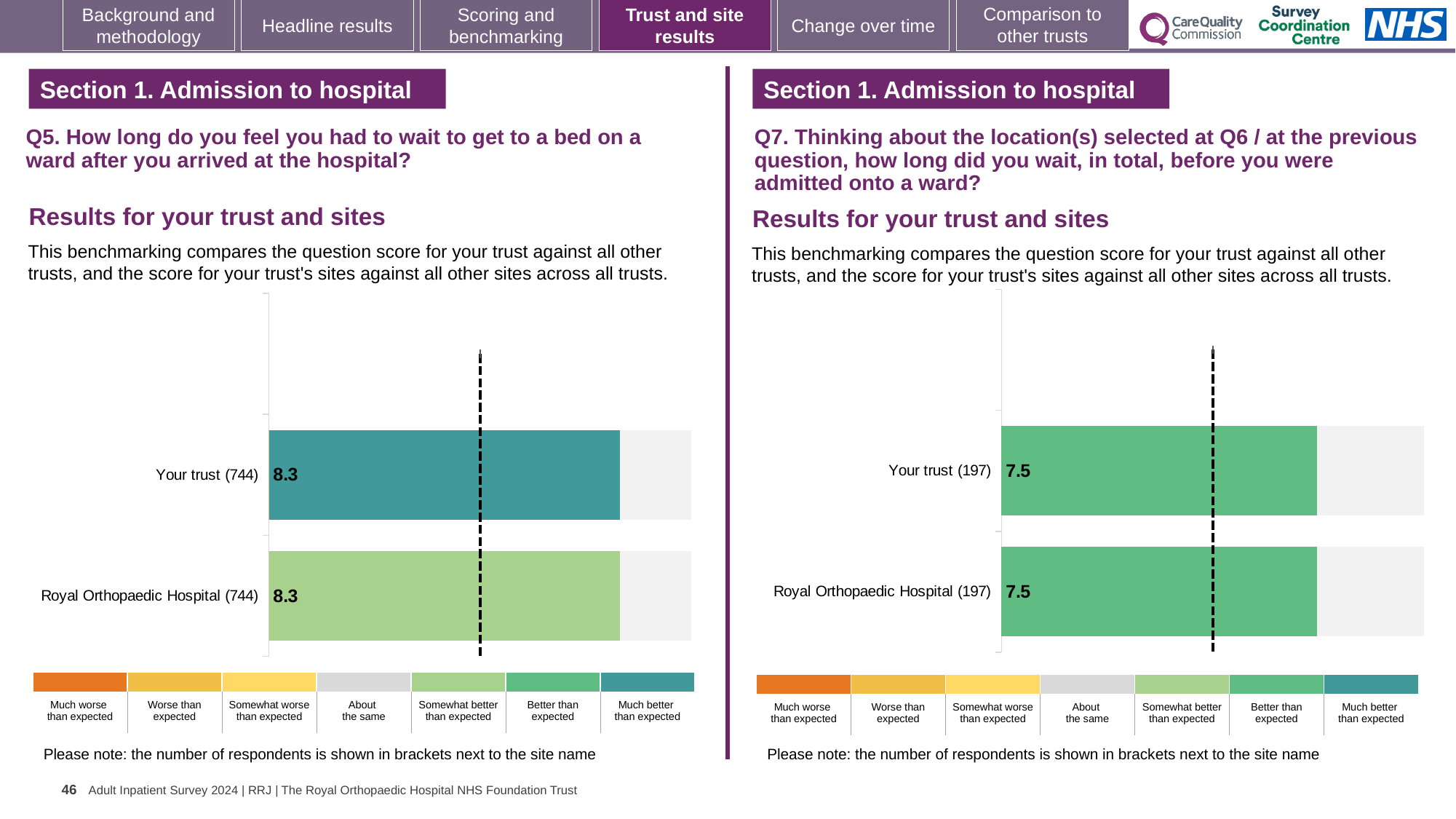
What kind of chart is used for the Q5 results on the left? Bar chart Is the score for Your trust in the left chart (Q5) larger or smaller than the score for Your trust in the right chart (Q7)? Larger In the right chart (Q7), what is the score for Your trust (197)? 7.5 In the right chart (Q7), how many respondents are shown in brackets for Royal Orthopaedic Hospital? 197 In the left chart (Q5), what is the score for Royal Orthopaedic Hospital (744)? 8.3 In the left chart (Q5), how many respondents are shown in brackets for Your trust? 744 How many bars are plotted in the right chart (Q7)? 2 In the right chart (Q7), what is the difference between the score for Your trust and the score for Royal Orthopaedic Hospital? 0 In the left chart (Q5), what is the score for Your trust (744)? 8.3 How many bars are plotted in the left chart (Q5)? 2 In the right chart (Q7), what is the score for Royal Orthopaedic Hospital (197)? 7.5 In the left chart (Q5), what is the difference between the score for Your trust and the score for Royal Orthopaedic Hospital? 0